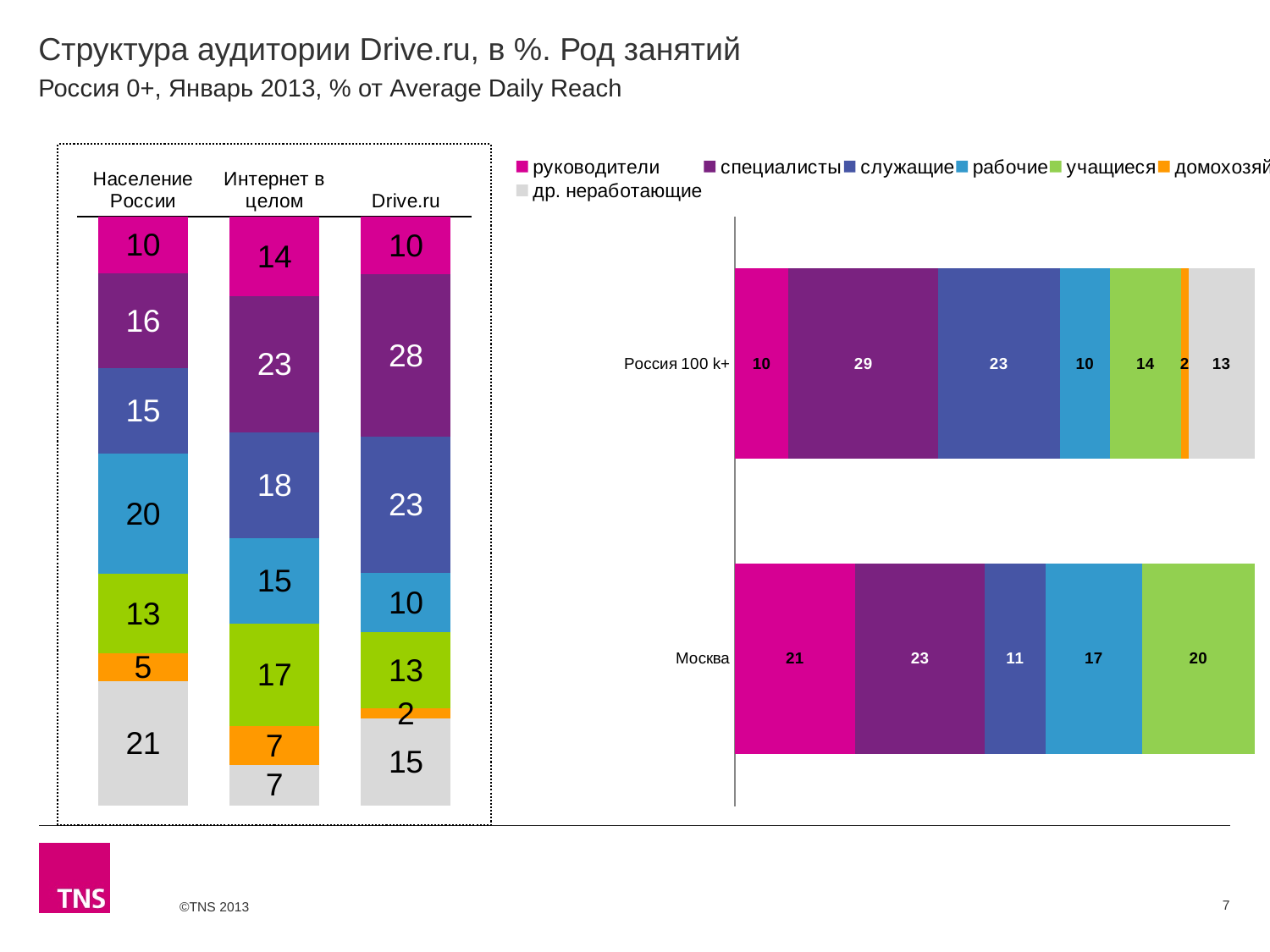
In the right chart, what is the value of the руководители (pink) segment for Москва? 21 How many series does the legend list? 7 In the left chart, what is the value of the др. неработающие (grey) segment for Население России? 21 In the right chart, which segment is the smallest for Россия 100 k+? домохозяйки (orange) What kind of chart is the right chart? Stacked horizontal bar chart In the left chart, what is the difference between the специалисты values for Drive.ru and Население России? 12 In the right chart, which is larger: the руководители value for Москва or for Россия 100 k+? Москва In the left chart, what is the value of the рабочие (light blue) segment for Интернет в целом? 15 How many bars does the left chart show? 3 In the right chart, what is the value of the специалисты (purple) segment for Россия 100 k+? 29 In the left chart, which segment is the largest for Drive.ru? специалисты In the left chart, what is the value of the специалисты (purple) segment for Drive.ru? 28